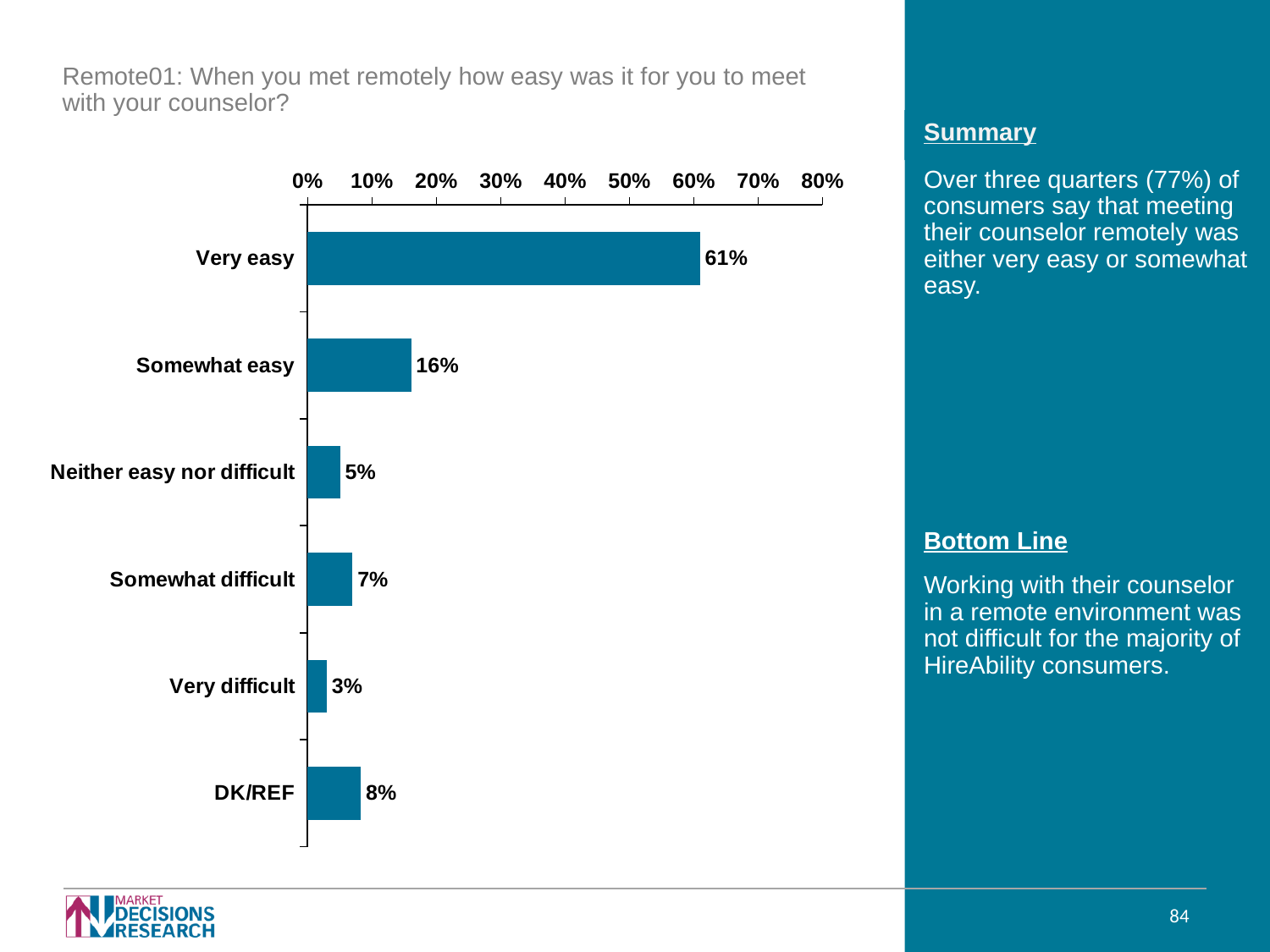
Which category has the highest value? Very easy Is the value for Very easy greater or less than 50%? greater What percentage of respondents said meeting remotely was very easy? 61% How many categories are shown in the chart? 6 Which category has the lowest value? Very difficult What is the value for Neither easy nor difficult? 5% What is the value for DK/REF? 8% What is the difference between the Very easy and Somewhat easy values? 45% What is the value for Somewhat easy? 16% What kind of chart is shown on the slide? Bar chart What is the difference between Somewhat difficult and Very difficult? 4% Which is larger, Somewhat difficult or DK/REF? DK/REF